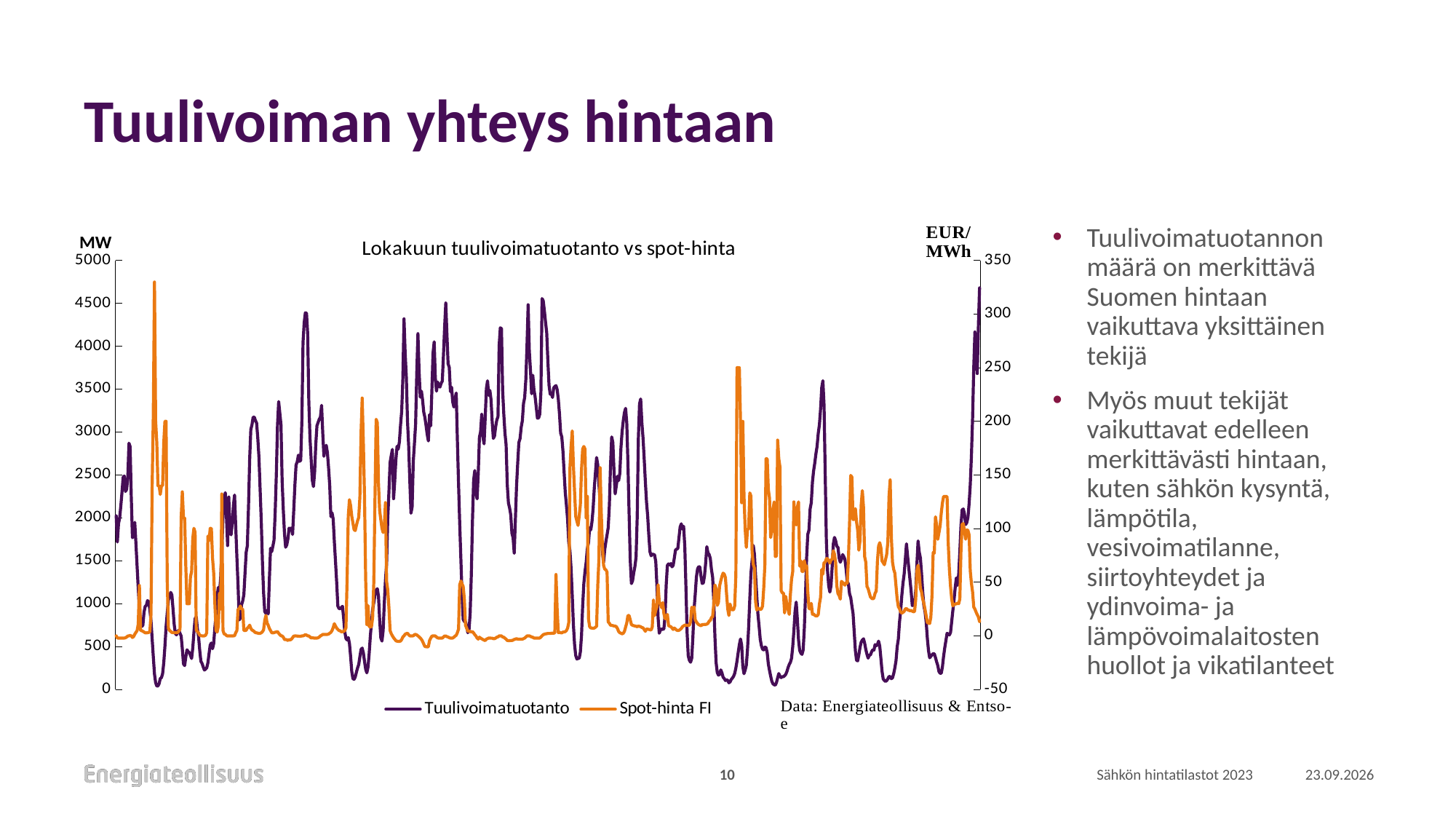
What is the title of the chart? Lokakuun tuulivoimatuotanto vs spot-hinta Which series is drawn in orange? Spot-hinta FI What kind of chart is shown on the slide? line chart Is the lowest value reached by the Tuulivoimatuotanto series greater or less than 500? less How many series does the chart's legend list? 2 Is the highest value reached by the Tuulivoimatuotanto series greater or less than 5000? less Is the highest value reached by the Spot-hinta FI series greater or less than 300? greater